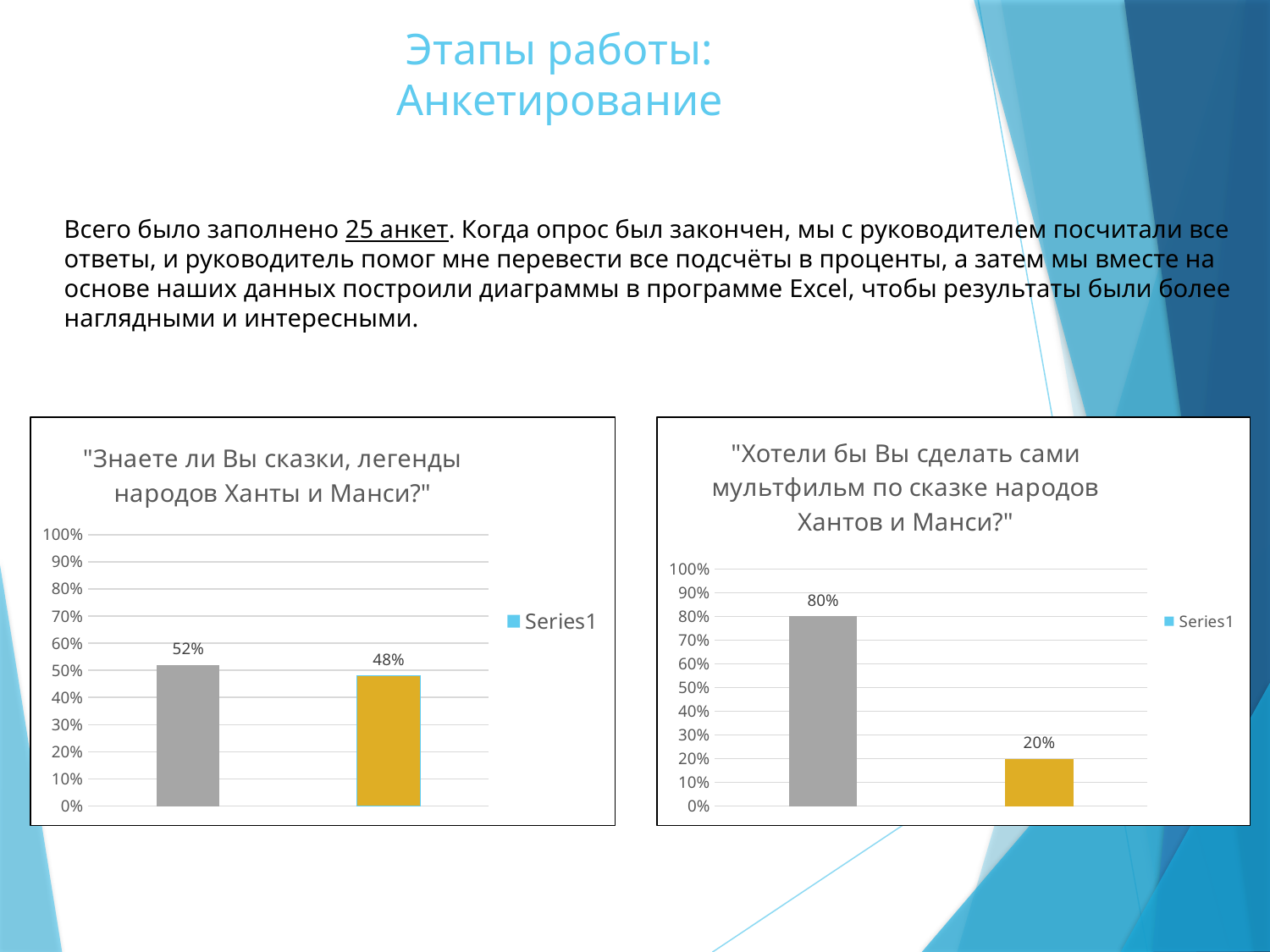
In the left chart titled "Знаете ли Вы сказки, легенды народов Ханты и Манси?", what value is shown on the gray (left) bar? 52% In the right chart titled "Хотели бы Вы сделать сами мультфильм по сказке народов Хантов и Манси?", what value is shown on the gray (left) bar? 80% What type of chart is the left chart? bar chart In the left chart titled "Знаете ли Вы сказки, легенды народов Ханты и Манси?", what value is shown on the yellow (right) bar? 48% How many bars are plotted in the left chart? 2 In the right chart, is the value of the yellow bar greater or less than 30%? less In the right chart, what is the difference between the gray bar and the yellow bar? 60% How many series does the legend of the right chart list? 1 In the right chart, which bar is higher, the gray one or the yellow one? the gray one In the right chart titled "Хотели бы Вы сделать сами мультфильм по сказке народов Хантов и Манси?", what value is shown on the yellow (right) bar? 20% What is the legend entry shown in the left chart? Series1 In the left chart, what is the difference between the gray bar and the yellow bar? 4%